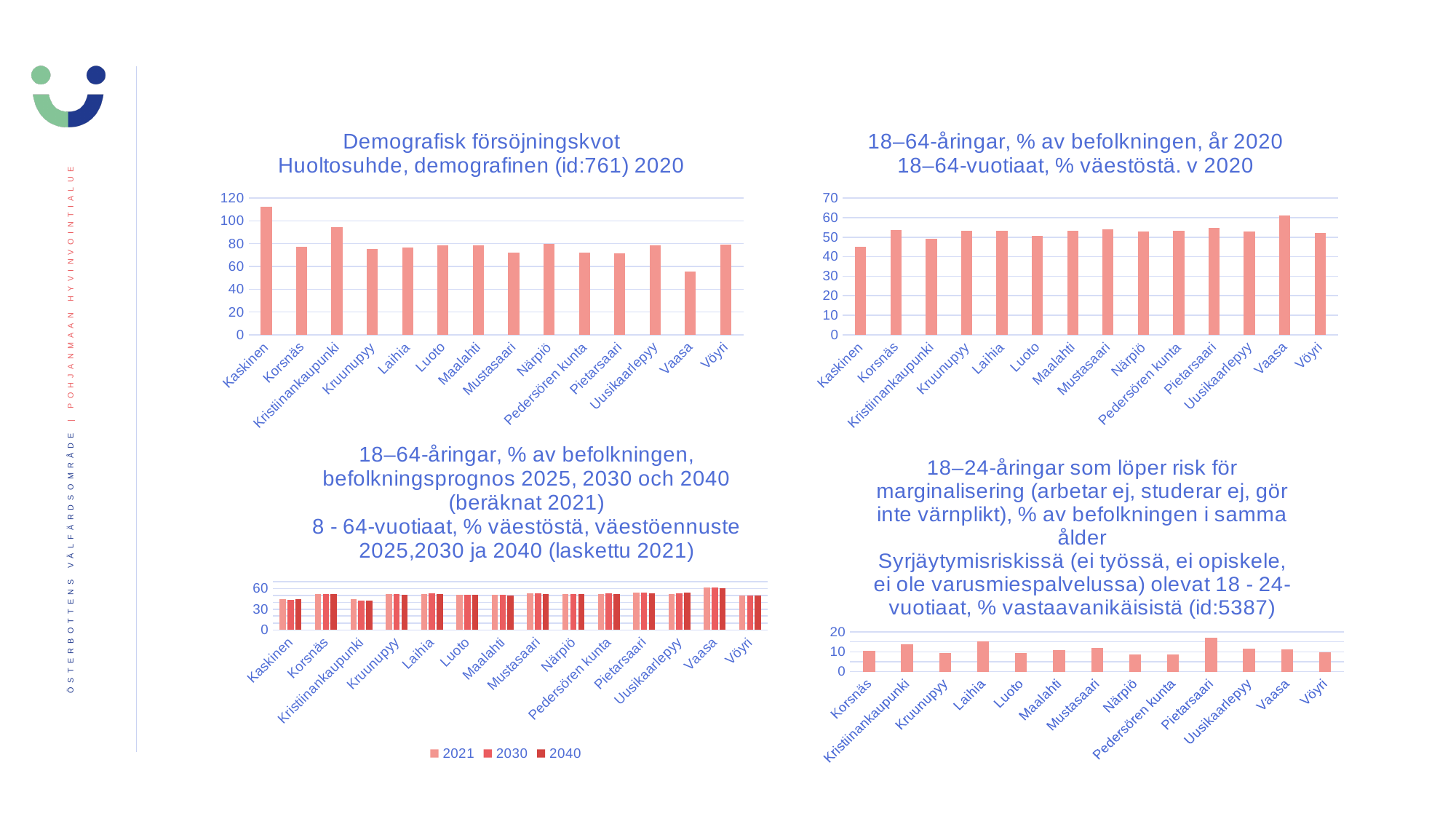
In the top-left chart (Demografisk försöjningskvot), which municipality has the highest value? Kaskinen In the top-right chart (18–64-åringar, % av befolkningen, år 2020), which municipality has the lowest value? Kaskinen How many series does the legend of the bottom-left chart (befolkningsprognos 2025, 2030 och 2040) list? 3 How many municipalities are shown in the bottom-right chart (18–24-åringar som löper risk för marginalisering)? 13 In the top-right chart (18–64-åringar, % av befolkningen, år 2020), which municipality has the highest value? Vaasa In the top-right chart (18–64-åringar, % av befolkningen, år 2020), is the value for Vaasa greater or less than 60? greater What type of chart is the bottom-left chart (befolkningsprognos 2025, 2030 och 2040)? bar chart In the top-left chart (Demografisk försöjningskvot), is the value for Kristiinankaupunki greater or less than 80? greater How many municipalities are shown in the top-left chart (Demografisk försöjningskvot)? 14 In the top-left chart (Demografisk försöjningskvot), is the value for Vaasa greater or less than 60? less In the top-left chart (Demografisk försöjningskvot), which municipality has the lowest value? Vaasa In the bottom-right chart (18–24-åringar som löper risk för marginalisering), which municipality has the highest value? Pietarsaari